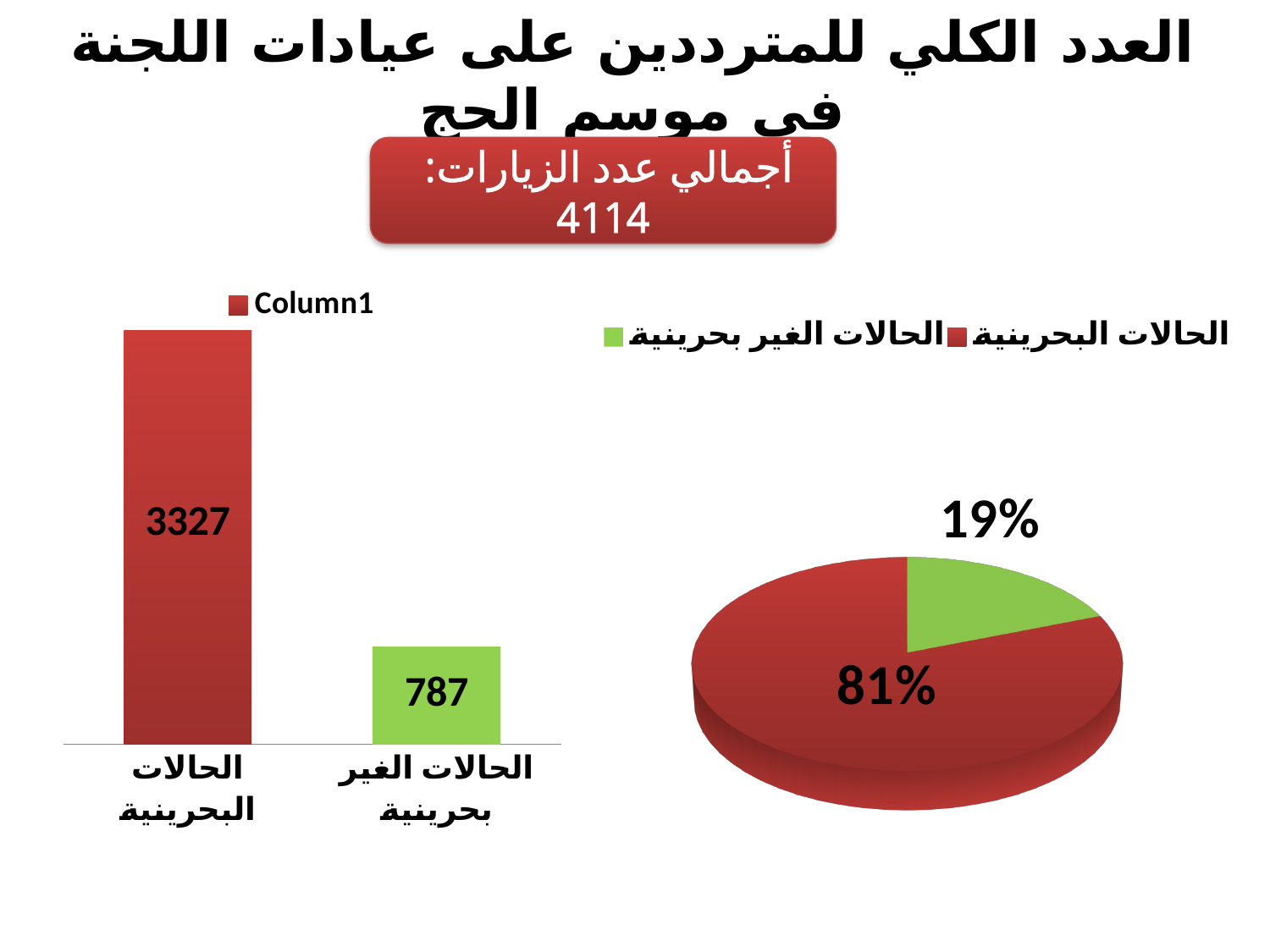
What kind of chart is the chart on the right of the slide? pie chart In the bar chart on the left, which category has the lowest value? الحالات الغير بحرينية In the bar chart on the left, what is the legend entry? Column1 In the pie chart on the right, what share does الحالات البحرينية have? 81% In the bar chart on the left, what is the value for الحالات البحرينية? 3327 In the bar chart on the left, what is the difference between the values for الحالات البحرينية and الحالات الغير بحرينية? 2540 In the pie chart on the right, what share does الحالات الغير بحرينية have? 19% What kind of chart is the chart on the left of the slide? bar chart In the bar chart on the left, what is the value for الحالات الغير بحرينية? 787 In the bar chart on the left, which category has the highest value? الحالات البحرينية In the bar chart on the left, how many categories are shown? 2 In the pie chart on the right, which slice is larger, الحالات البحرينية or الحالات الغير بحرينية? الحالات البحرينية